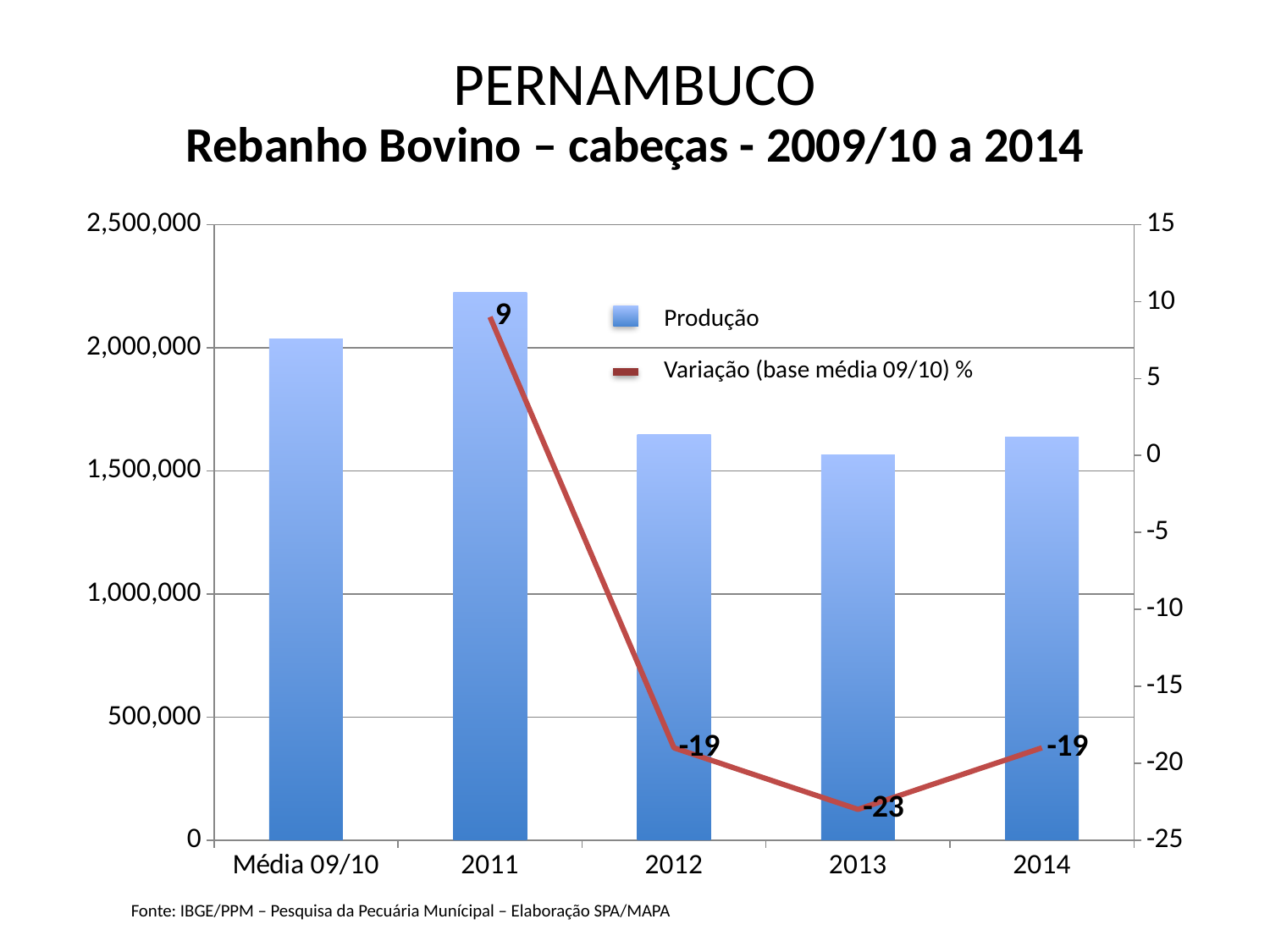
Is the Produção value for 2013 greater or less than 2,000,000? less Does the Variação line rise or fall from 2011 to 2013? fall Which year has the lowest value of Variação (base média 09/10) %? 2013 What is the value of Variação (base média 09/10) % for 2013? -23 How many categories are shown on the x axis? 5 What is the value of Variação (base média 09/10) % for 2011? 9 Which has a larger Produção bar, Média 09/10 or 2012? Média 09/10 Which category has the highest Produção bar? 2011 What is the value of Variação (base média 09/10) % for 2014? -19 What is the difference between the Variação values for 2011 and 2013? 32 How many series does the legend list? 2